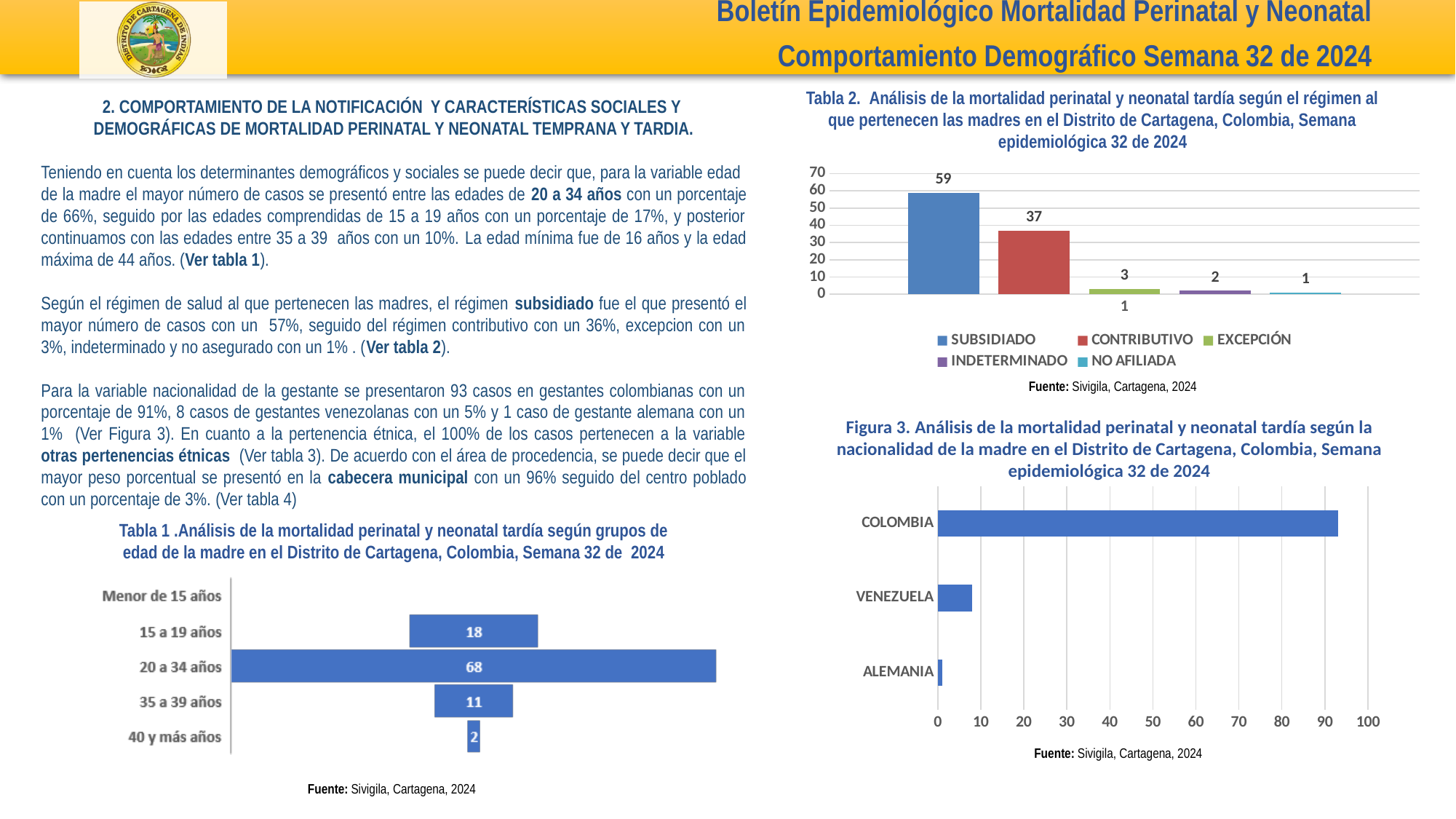
In the chart titled 'Tabla 2', what is the value for SUBSIDIADO? 59 In the chart titled 'Tabla 1', what is the value for '20 a 34 años'? 68 In the chart titled 'Tabla 1', how many age-group categories are listed on the axis? 5 In the chart titled 'Figura 3', is the value for COLOMBIA greater or less than 90? greater In the chart titled 'Tabla 2', what is the difference between SUBSIDIADO and CONTRIBUTIVO? 22 In the chart titled 'Tabla 1', what is the value for '15 a 19 años'? 18 In the chart titled 'Tabla 2', how many entries does the legend list? 5 In the chart titled 'Tabla 1', what is the difference between the values for '20 a 34 años' and '15 a 19 años'? 50 In the chart titled 'Tabla 1', which age group has the highest value? 20 a 34 años In the chart titled 'Figura 3', what kind of chart is shown? bar chart In the chart titled 'Tabla 2', what is the value for CONTRIBUTIVO? 37